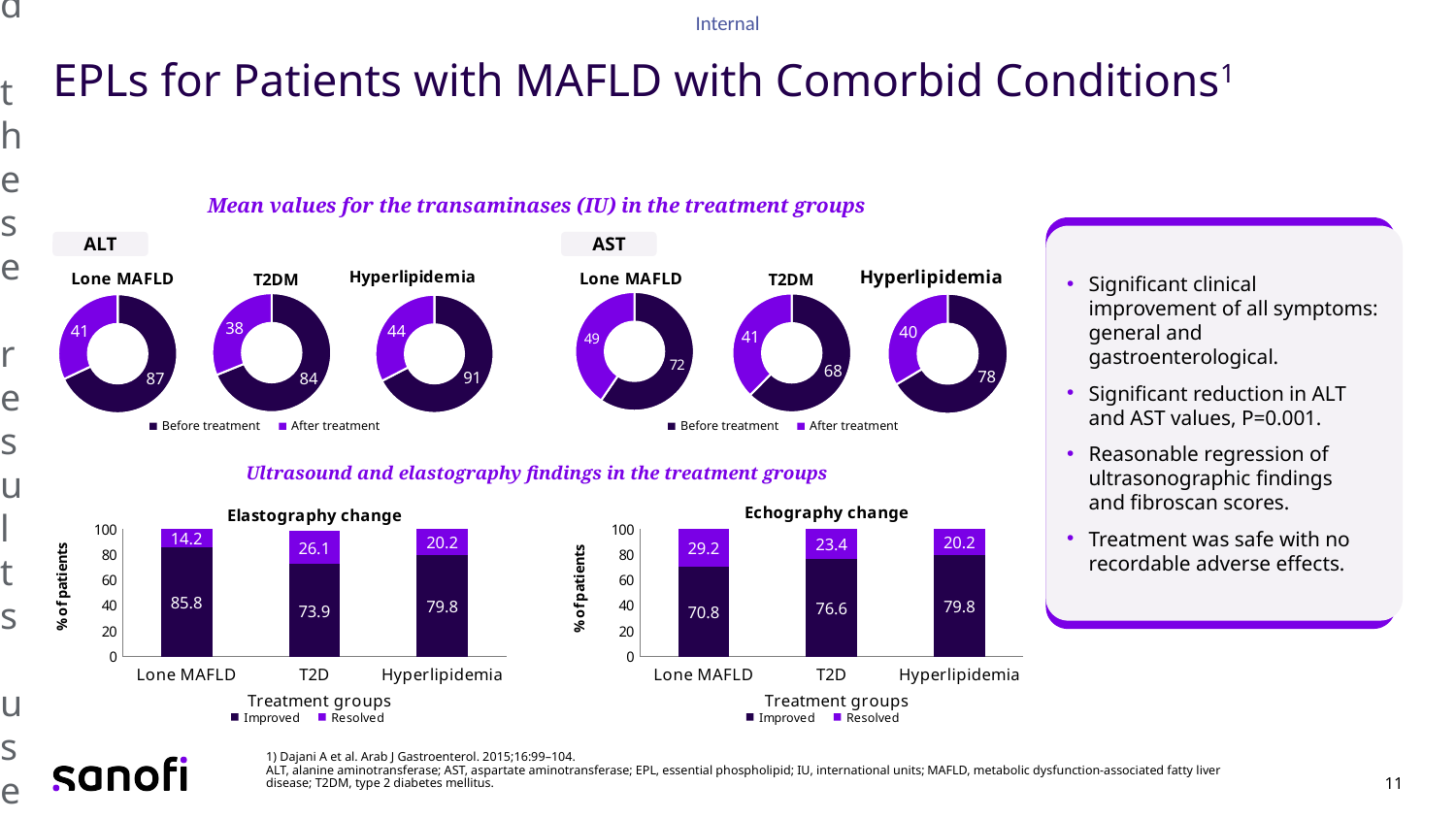
What type of chart is the Echography change chart? Stacked bar chart In the ALT T2DM donut chart, what is the value after treatment? 38 In the Echography change chart, what is the Improved value for Lone MAFLD? 70.8 How many treatment groups are shown on the x axis of the Elastography change chart? 3 In the Elastography change chart, what is the Resolved value for T2D? 26.1 In the Elastography change chart, what percentage of Lone MAFLD patients improved? 85.8 In the AST Hyperlipidemia donut chart, what is the value before treatment? 78 In the AST Lone MAFLD donut chart, what is the difference between the before-treatment and after-treatment values? 23 In the ALT Lone MAFLD donut chart, what is the value before treatment? 87 Among the three ALT donut charts, which treatment group has the highest before-treatment value? Hyperlipidemia In the Echography change chart, which treatment group has the highest Resolved value? Lone MAFLD In the Echography change chart, what is the total of the stacked bar for T2D? 100